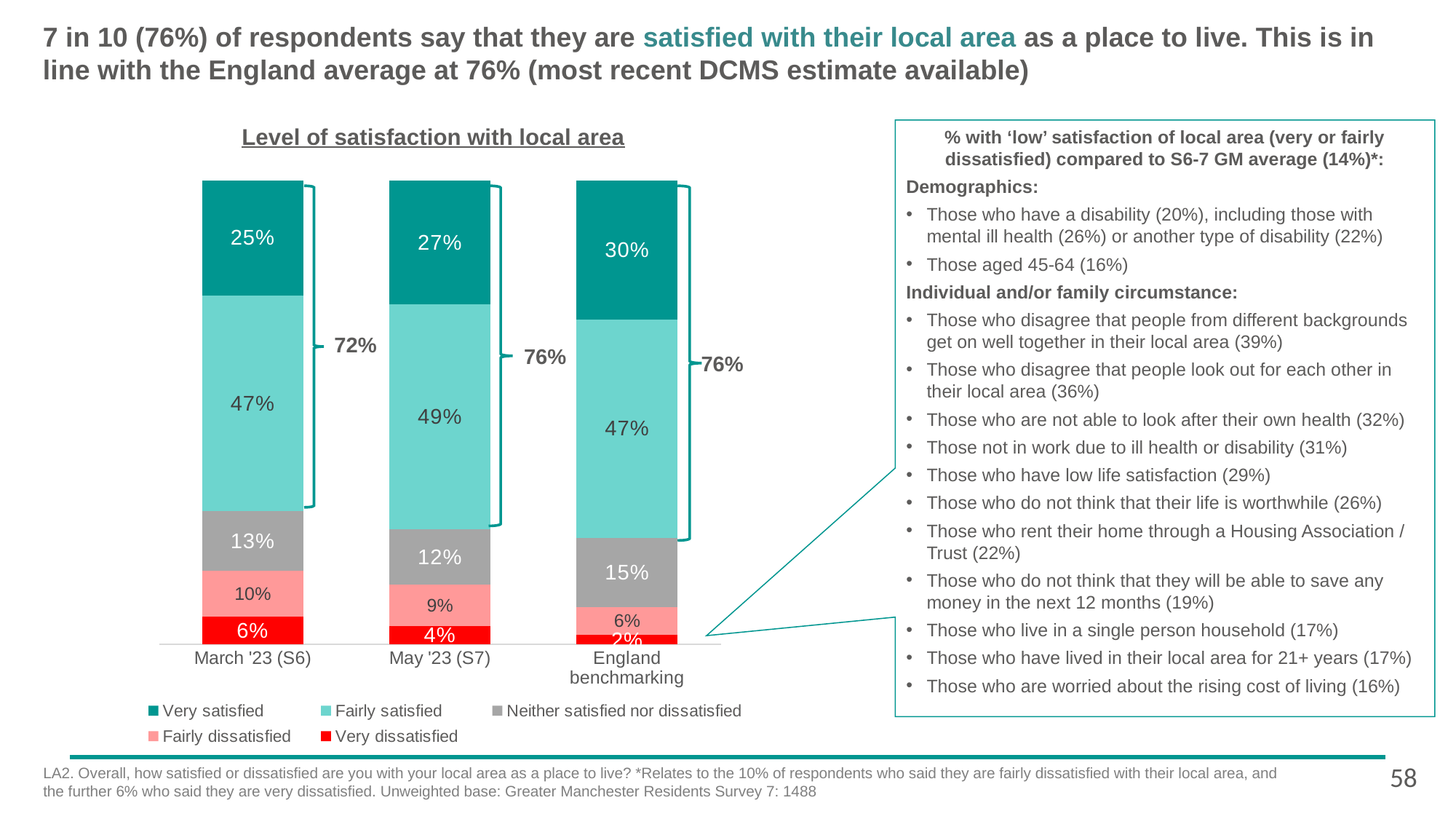
How many series does the legend of the 'Level of satisfaction with local area' chart list? 5 Is the 'Fairly satisfied' value larger for May '23 (S7) or for England benchmarking? May '23 (S7) What is the difference between the 'Fairly dissatisfied' values for March '23 (S6) and May '23 (S7)? 1% How many categories are shown on the x axis of the 'Level of satisfaction with local area' chart? 3 What percentage of respondents were 'Very satisfied' in May '23 (S7)? 27% What type of chart is shown under the title 'Level of satisfaction with local area'? Stacked bar chart What percentage of respondents were 'Fairly satisfied' in March '23 (S6)? 47% Which category has the lowest 'Very dissatisfied' value? England benchmarking Which category has the highest 'Very satisfied' value? England benchmarking What combined satisfied percentage (very plus fairly satisfied) is labelled by the bracket for March '23 (S6)? 72% What is the 'Very dissatisfied' value for England benchmarking? 2% What is the 'Neither satisfied nor dissatisfied' value for England benchmarking? 15%